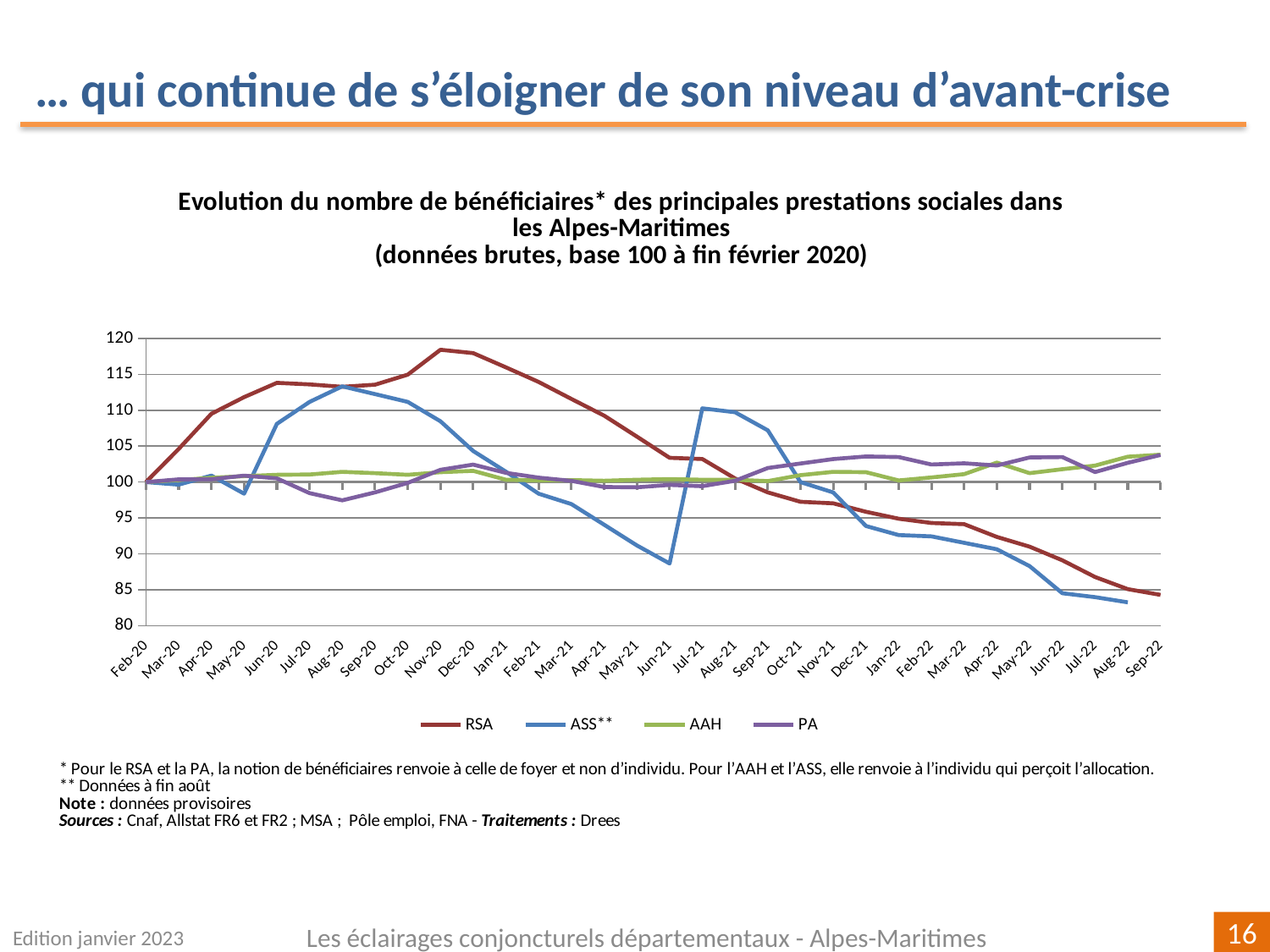
Does the RSA series rise or fall from Nov-20 to Sep-22? fall Which series has the highest value in Nov-20? RSA Which series has the lowest value in Jun-21? ASS** Is the value for ASS** in Jul-21 greater or less than 105? greater What kind of chart is shown on the slide? line chart How many monthly points are shown on the x axis, from Feb-20 to Sep-22? 32 How many series does the legend list? 4 Is the value for RSA in Nov-20 greater or less than 115? greater In Jul-21, which is larger, the value for RSA or the value for ASS**? ASS** Is the value for RSA in Sep-22 greater or less than 90? less